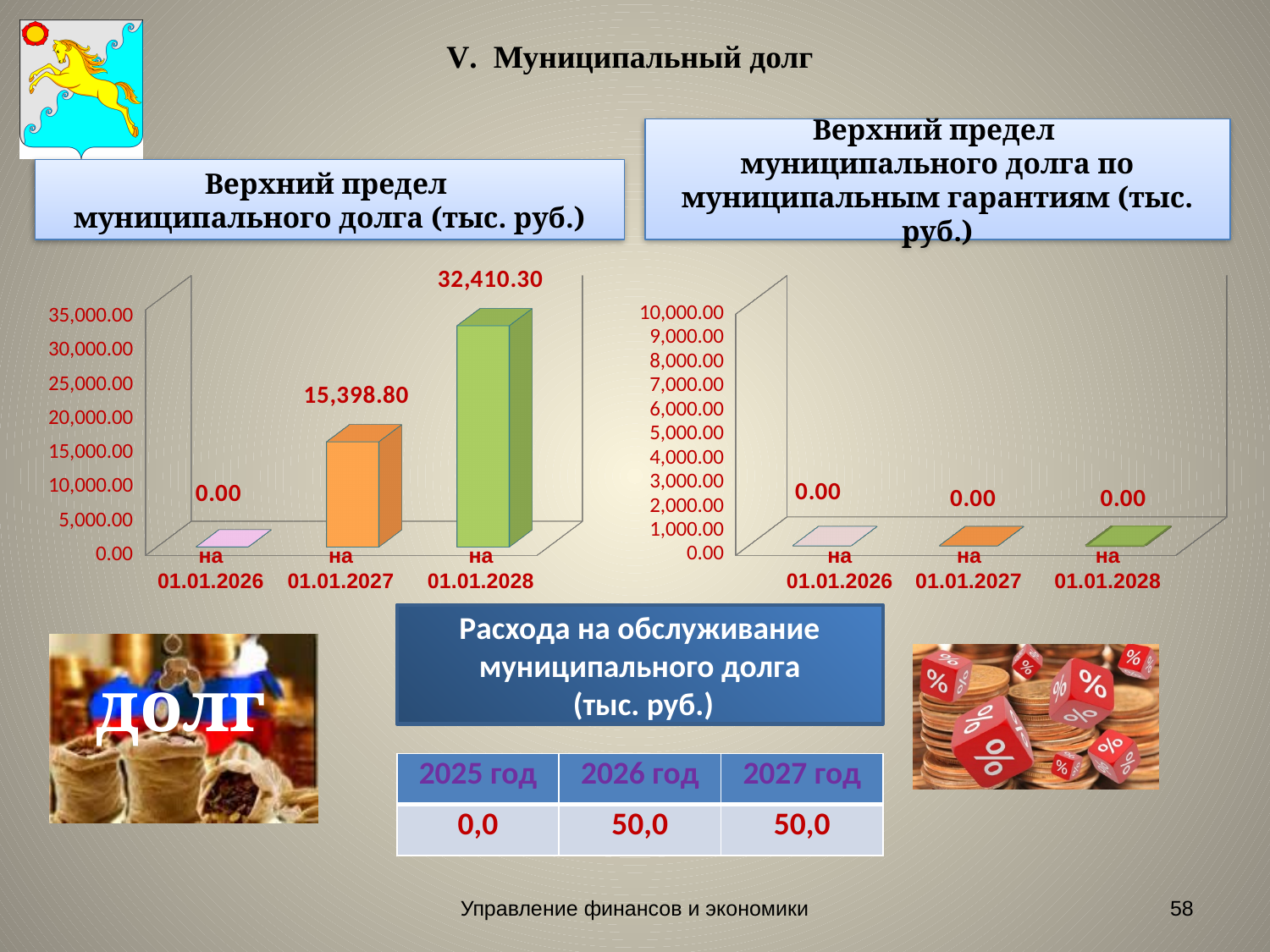
In the left chart 'Верхний предел муниципального долга (тыс. руб.)', what is the value for на 01.01.2028? 32,410.30 In the left chart 'Верхний предел муниципального долга (тыс. руб.)', what is the value for на 01.01.2027? 15,398.80 In the right chart 'Верхний предел муниципального долга по муниципальным гарантиям (тыс. руб.)', what is the value for на 01.01.2027? 0.00 In the left chart 'Верхний предел муниципального долга (тыс. руб.)', what is the value for на 01.01.2026? 0.00 What kind of chart is the left chart 'Верхний предел муниципального долга (тыс. руб.)'? bar chart In the left chart 'Верхний предел муниципального долга (тыс. руб.)', which category has the lowest value? на 01.01.2026 In the left chart 'Верхний предел муниципального долга (тыс. руб.)', do the values rise or fall from на 01.01.2026 to на 01.01.2028? rise In the left chart 'Верхний предел муниципального долга (тыс. руб.)', is the value for на 01.01.2028 greater or less than 30,000.00? greater In the left chart 'Верхний предел муниципального долга (тыс. руб.)', which is larger: the value for на 01.01.2027 or на 01.01.2028? на 01.01.2028 How many categories are shown in the right chart 'Верхний предел муниципального долга по муниципальным гарантиям (тыс. руб.)'? 3 In the left chart 'Верхний предел муниципального долга (тыс. руб.)', what is the difference between the values for на 01.01.2028 and на 01.01.2027? 17,011.50 In the left chart 'Верхний предел муниципального долга (тыс. руб.)', which category has the highest value? на 01.01.2028